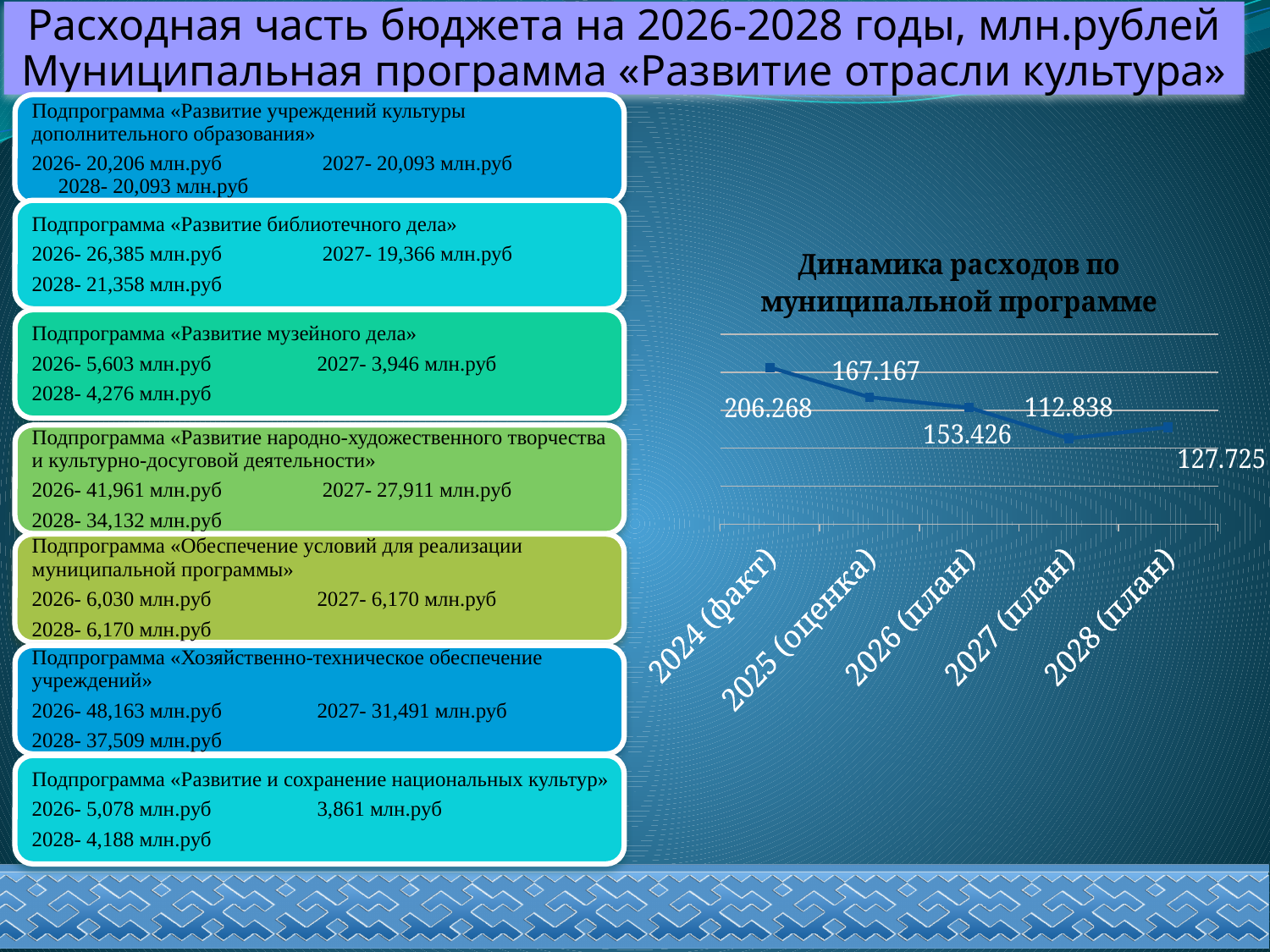
What is the difference between the values for 2024 (факт) and 2025 (оценка)? 39.101 How many data points are plotted on the chart? 5 What is the value for 2025 (оценка) on the chart? 167.167 What is the value for 2026 (план) on the chart? 153.426 What is the value for 2028 (план) on the chart? 127.725 Which category has the highest value on the chart? 2024 (факт) What is the value for 2027 (план) on the chart? 112.838 What type of chart is shown on the slide? line chart Which category has the lowest value on the chart? 2027 (план) What is the title of the chart on the slide? Динамика расходов по муниципальной программе What is the value for 2024 (факт) on the chart? 206.268 Which is larger, the value for 2027 (план) or the value for 2028 (план)? 2028 (план)